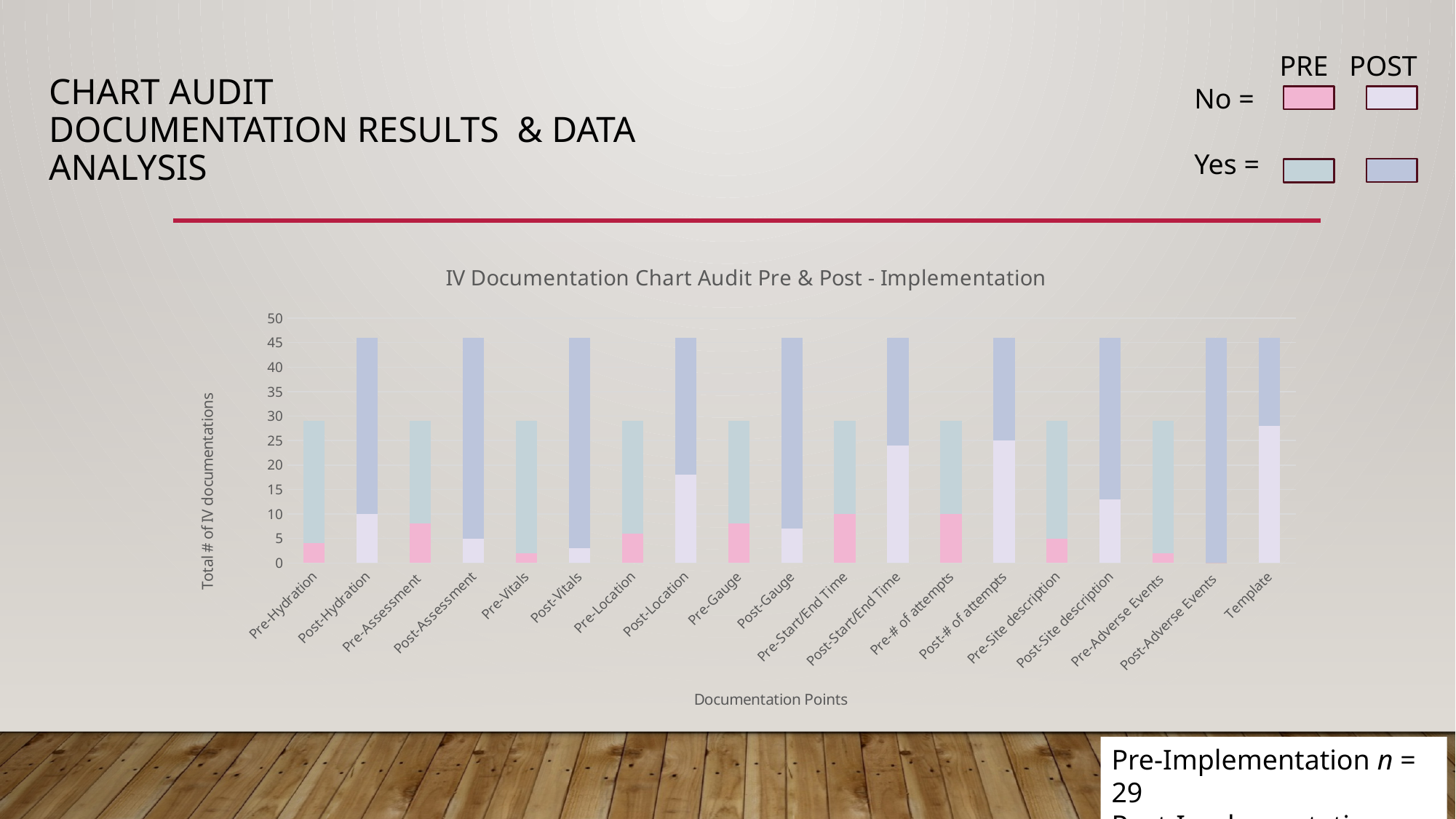
What type of chart is shown on the slide? Stacked bar chart Is the 'No' portion of the Post-Location bar greater or less than 15? greater What is the title of the chart? IV Documentation Chart Audit Pre & Post - Implementation Is the 'No' portion of the Pre-Vitals bar greater or less than 5? less Is the total height of the Post-Hydration bar greater or less than 40? greater Which has the larger 'No' portion: the Post-# of attempts bar or the Post-Hydration bar? Post-# of attempts How many documentation point categories are shown along the x axis? 19 What is the label on the vertical axis of the chart? Total # of IV documentations Which has the larger 'No' portion: the Template bar or the Post-Location bar? Template